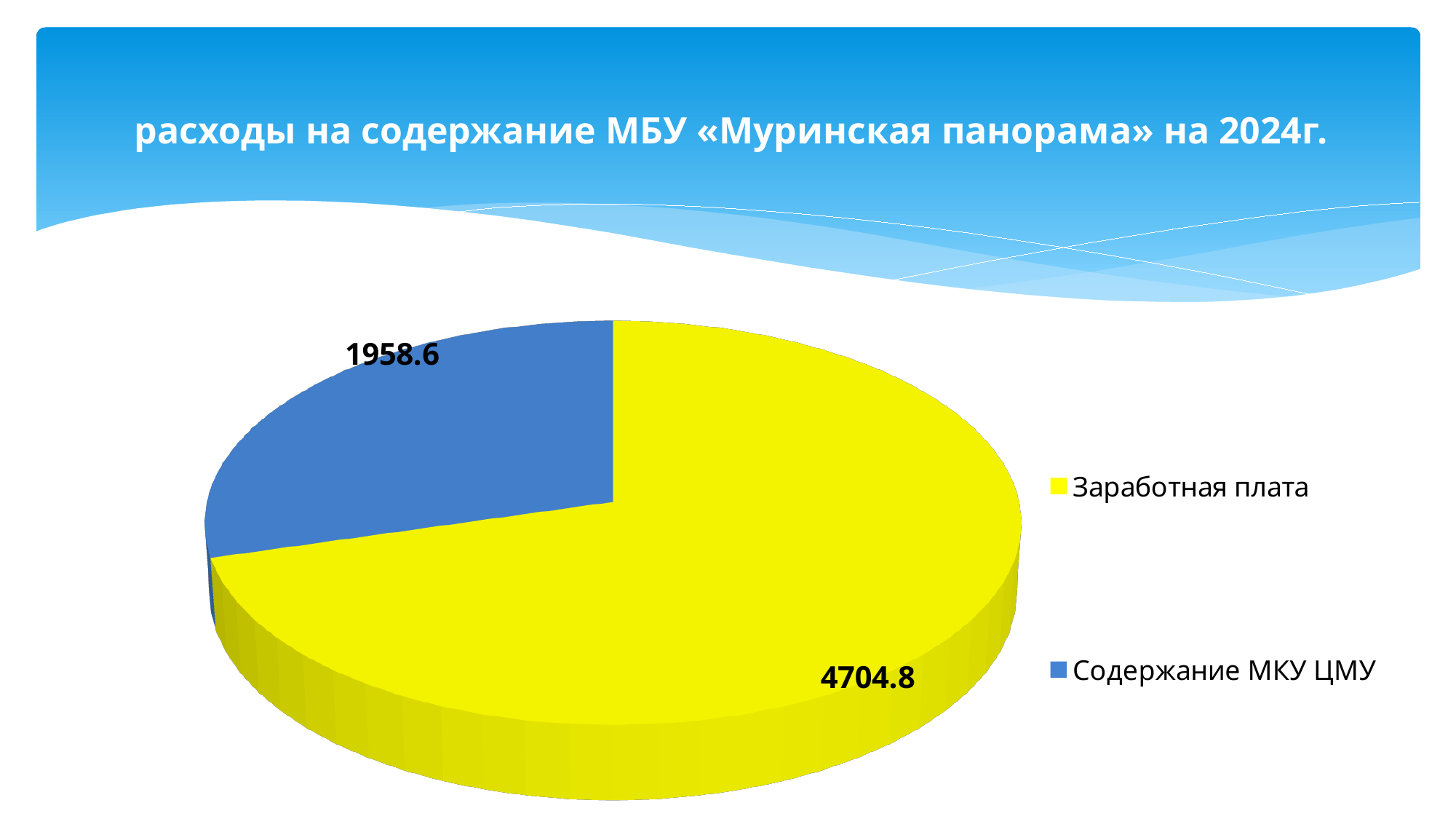
What is the total of the two values shown in the pie chart? 6663.4 What kind of chart is shown on the slide? Pie chart How many entries does the legend list? 2 What is the value for Заработная плата in the pie chart? 4704.8 What share of the pie does Заработная плата represent, to one decimal place? 70.6% Which category has the smallest slice of the pie chart? Содержание МКУ ЦМУ Which is larger: Заработная плата or Содержание МКУ ЦМУ? Заработная плата How many slices does the pie chart have? 2 What is the value for Содержание МКУ ЦМУ in the pie chart? 1958.6 What is the difference between the values for Заработная плата and Содержание МКУ ЦМУ? 2746.2 Which category has the largest slice of the pie chart? Заработная плата What colour is the slice for Содержание МКУ ЦМУ? Blue